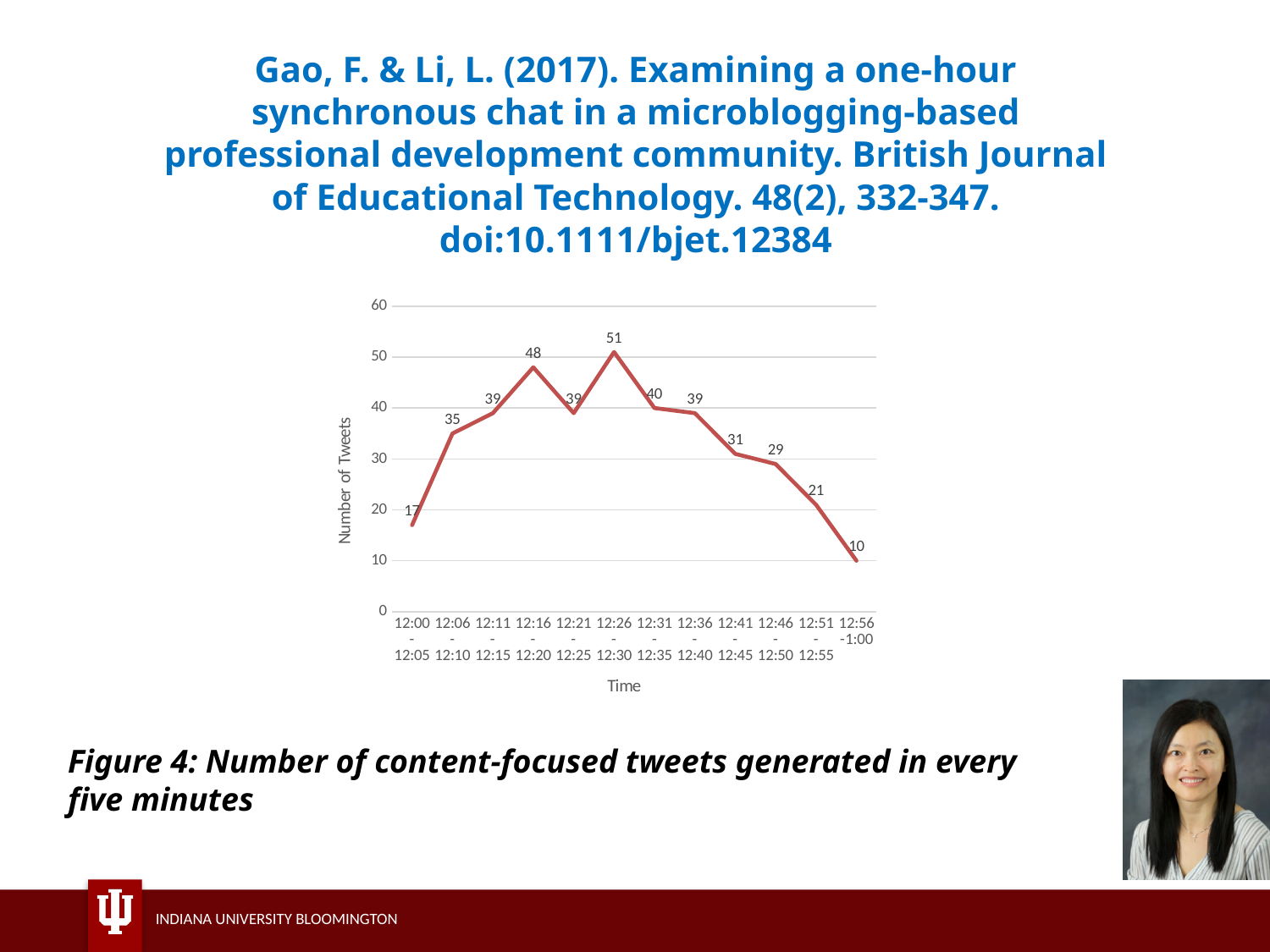
Is the value for the 12:06-12:10 interval greater or less than 30? greater Which time interval has the lowest number of tweets? 12:56-1:00 What is the number of tweets for the 12:00-12:05 interval? 17 Which interval has more tweets, 12:41-12:45 or 12:46-12:50? 12:41-12:45 What is the number of tweets for the 12:56-1:00 interval? 10 What type of chart is shown on the slide? line chart Which time interval has the highest number of tweets? 12:26-12:30 What is the number of tweets for the 12:16-12:20 interval? 48 What is the label of the vertical axis? Number of Tweets How many time intervals are plotted on the x axis? 12 What is the difference in number of tweets between the 12:26-12:30 interval and the 12:00-12:05 interval? 34 Do the values rise or fall from the 12:36-12:40 interval to the 12:56-1:00 interval? fall